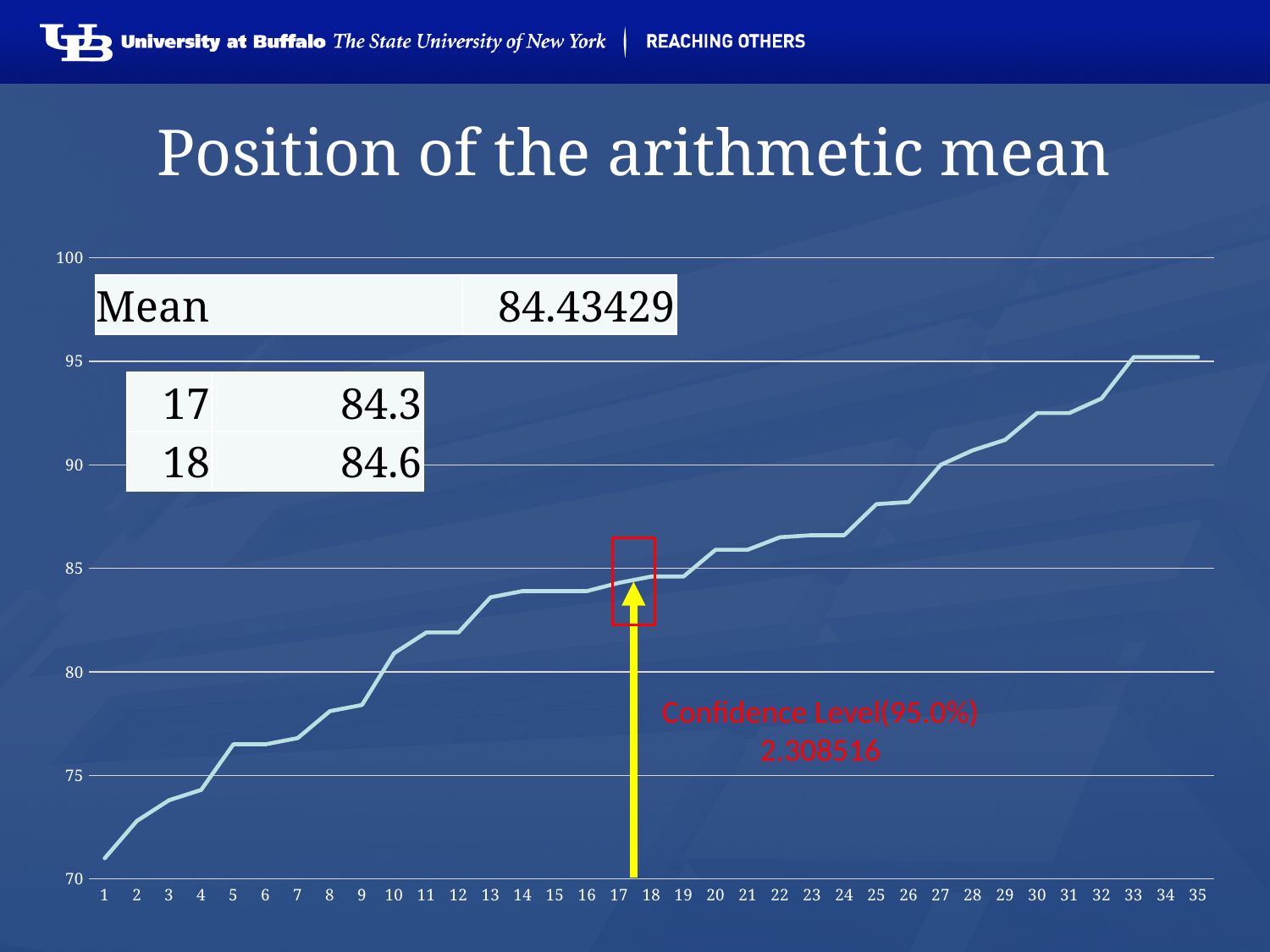
What is the value at point 17 according to the table on the chart? 84.3 Do the values rise or fall as you move from point 1 to point 35? rise What is the value at point 18 according to the table on the chart? 84.6 How many points are plotted along the x axis? 35 Is the value at point 30 greater or less than 90? greater What kind of chart is shown on the slide? line chart What is the difference between the values at points 18 and 17? 0.3 Which point has the lowest value? 1 What mean value is printed on the chart? 84.43429 What is the title of the chart? Position of the arithmetic mean Which has the larger value, point 10 or point 30? point 30 Is the value at point 1 greater or less than 75? less